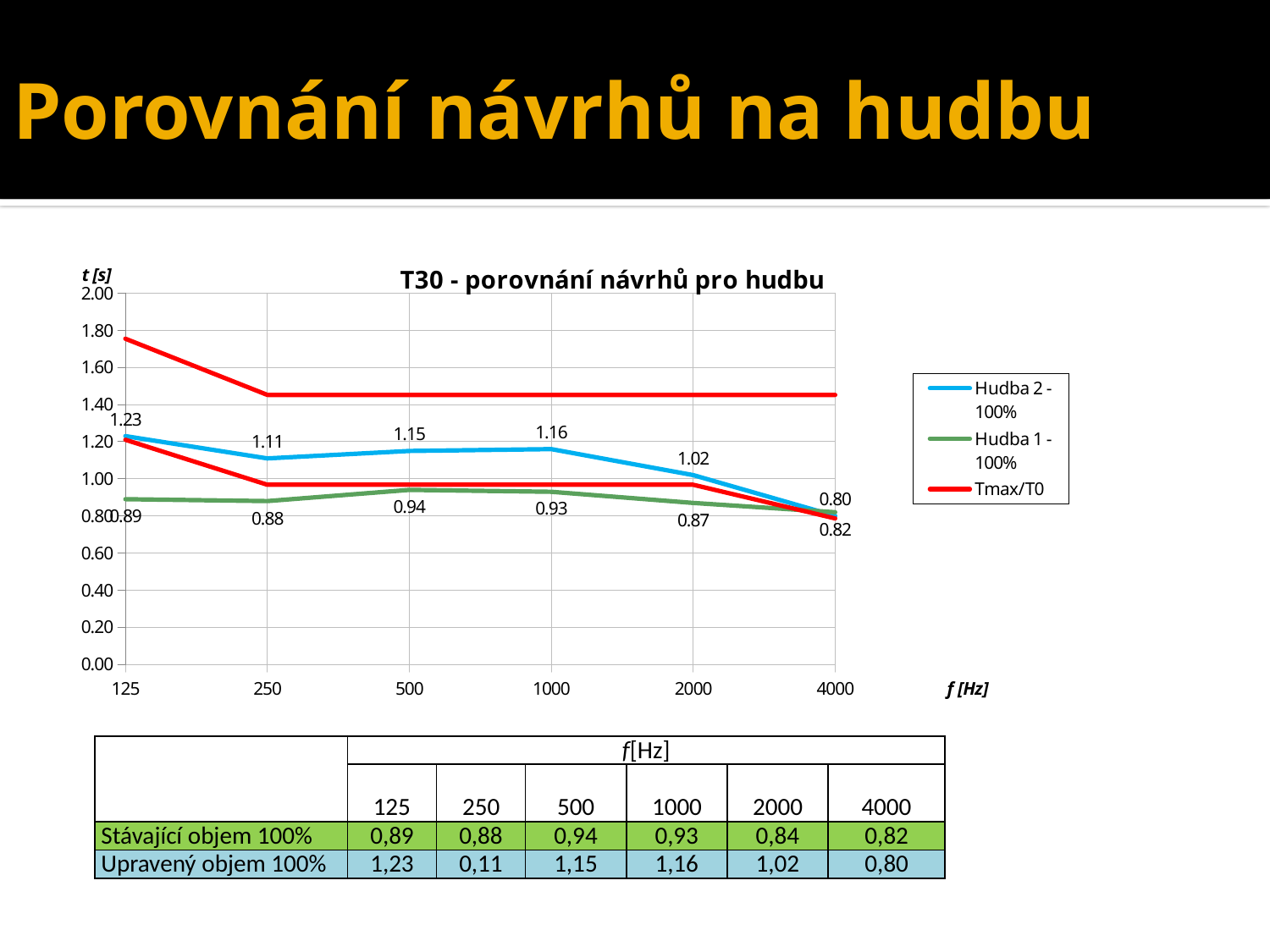
At which frequency does the Hudba 2 - 100% series reach its highest value? 125 What is the value of the Hudba 1 - 100% series at 500 Hz? 0.94 How many frequency points are plotted along the x axis? 6 What is the value of the Hudba 2 - 100% series at 2000 Hz? 1.02 Which series has the larger value at 250 Hz, Hudba 2 - 100% or Hudba 1 - 100%? Hudba 2 - 100% How many series does the legend list? 3 What kind of chart is shown on the slide? line chart At which frequency does the Hudba 1 - 100% series have its lowest value? 4000 What is the value of the Hudba 2 - 100% series at 125 Hz? 1.23 What is the difference between the Hudba 2 - 100% and Hudba 1 - 100% values at 1000 Hz? 0.23 Is the value of the upper Tmax/T0 line at 125 Hz greater or less than 1.60? greater Does the Hudba 2 - 100% series rise or fall from 1000 Hz to 4000 Hz? fall